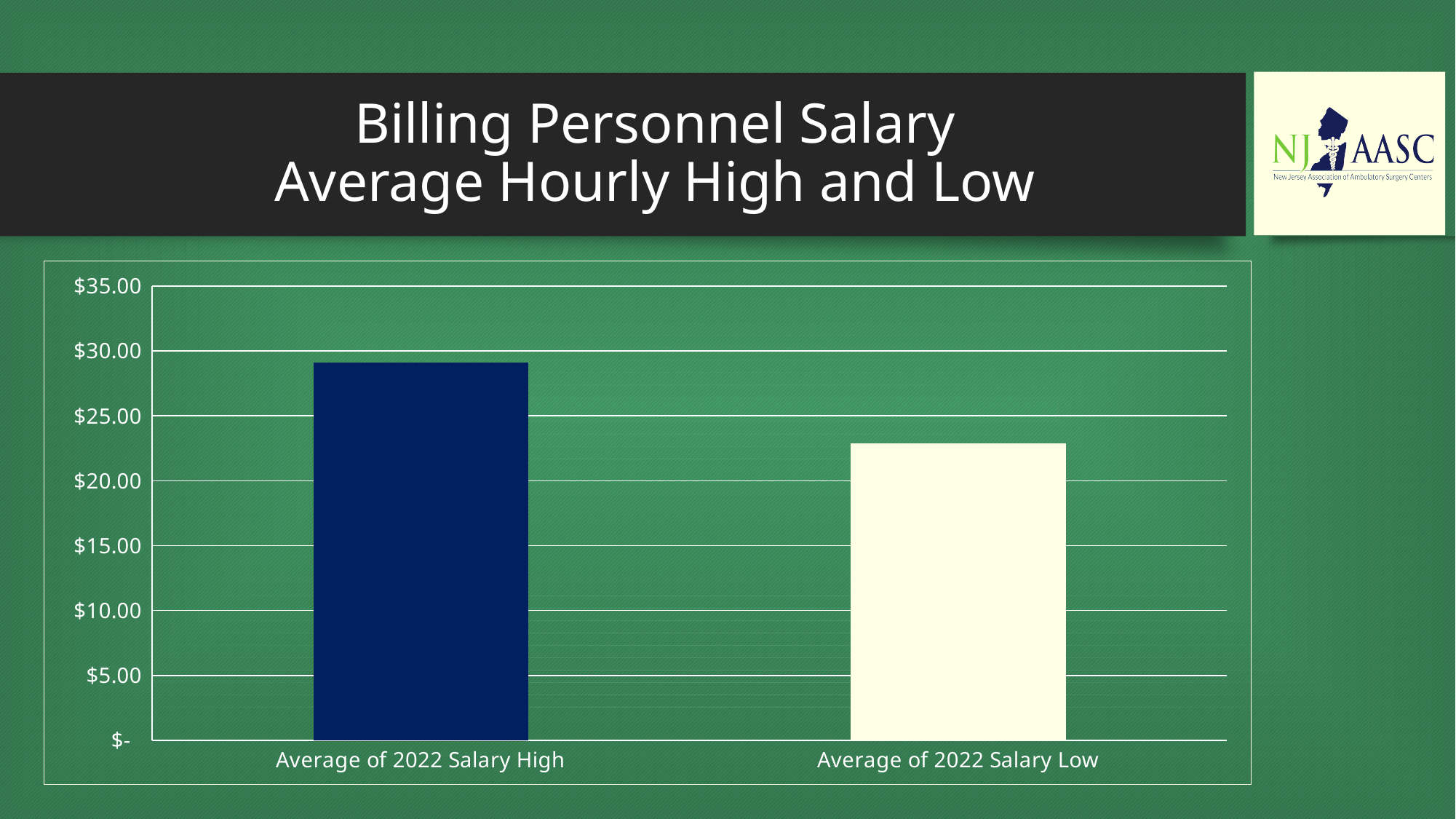
Is the value for Average of 2022 Salary Low greater or less than $20.00? greater Is the value for Average of 2022 Salary High greater or less than $30.00? less Which is larger, the value for Average of 2022 Salary High or Average of 2022 Salary Low? Average of 2022 Salary High Is the value for Average of 2022 Salary Low greater or less than $25.00? less What is the highest value shown on the vertical axis? $35.00 What kind of chart is shown on the slide? bar chart What is the title of the slide containing the chart? Billing Personnel Salary Average Hourly High and Low How many bars are plotted in the chart? 2 Which category has the lowest value? Average of 2022 Salary Low Which category has the highest value? Average of 2022 Salary High